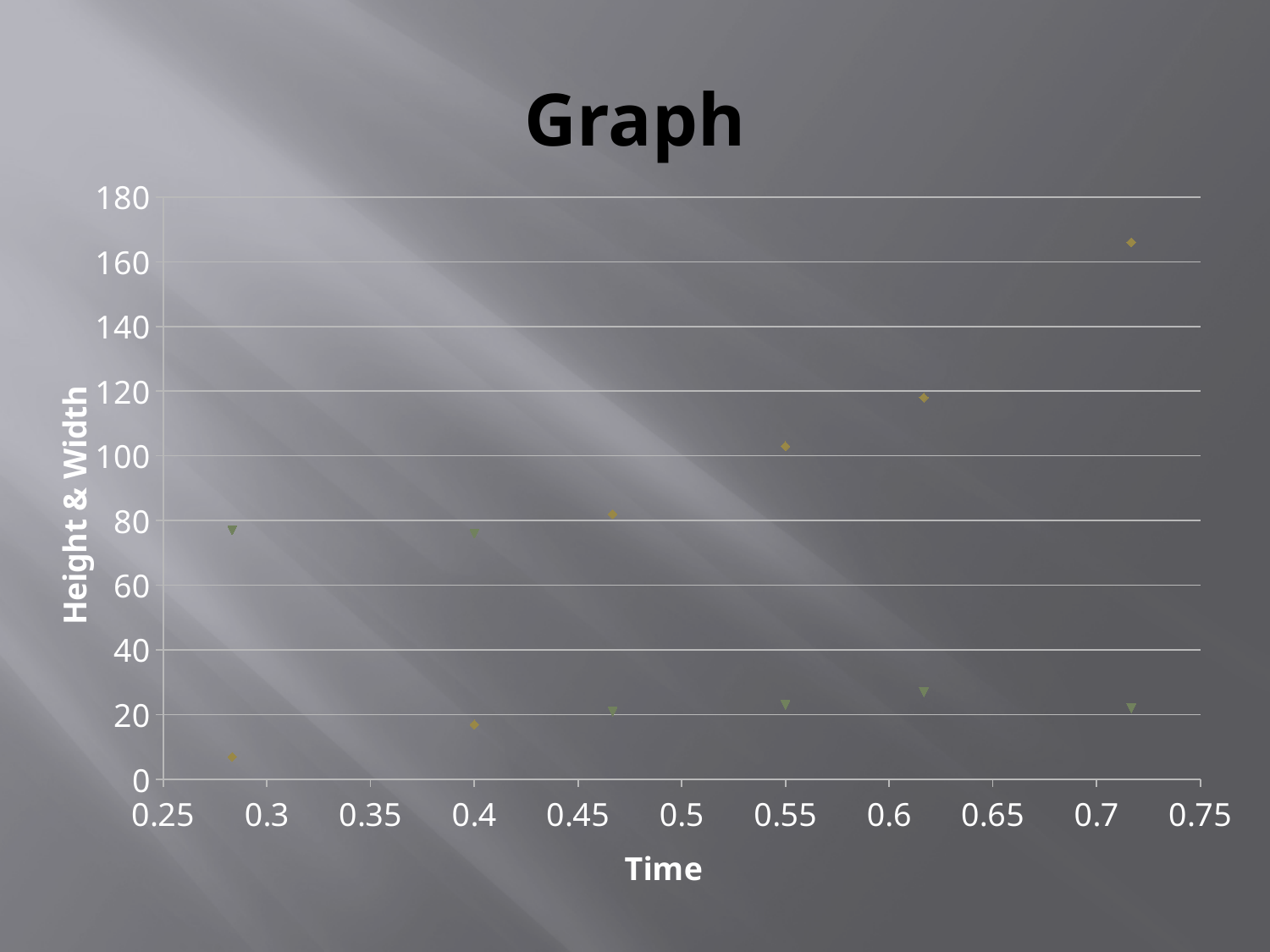
What is the label on the vertical axis of the chart? Height & Width At the rightmost Time value, which series has the larger value: the diamond markers or the triangle markers? diamond markers At the leftmost Time value, which series has the larger value: the diamond markers or the triangle markers? triangle markers Is the value of the rightmost triangle-marker point greater or less than 40? less What is the title of the chart? Graph How many triangle-marker points are plotted on the chart? 6 How many diamond-marker points are plotted on the chart? 6 Is the value of the rightmost diamond-marker point greater or less than 160? greater What kind of chart is shown on the slide? scatter chart Do the diamond-marker values rise or fall as Time increases along the x axis? rise Is the value of the leftmost triangle-marker point greater or less than 60? greater